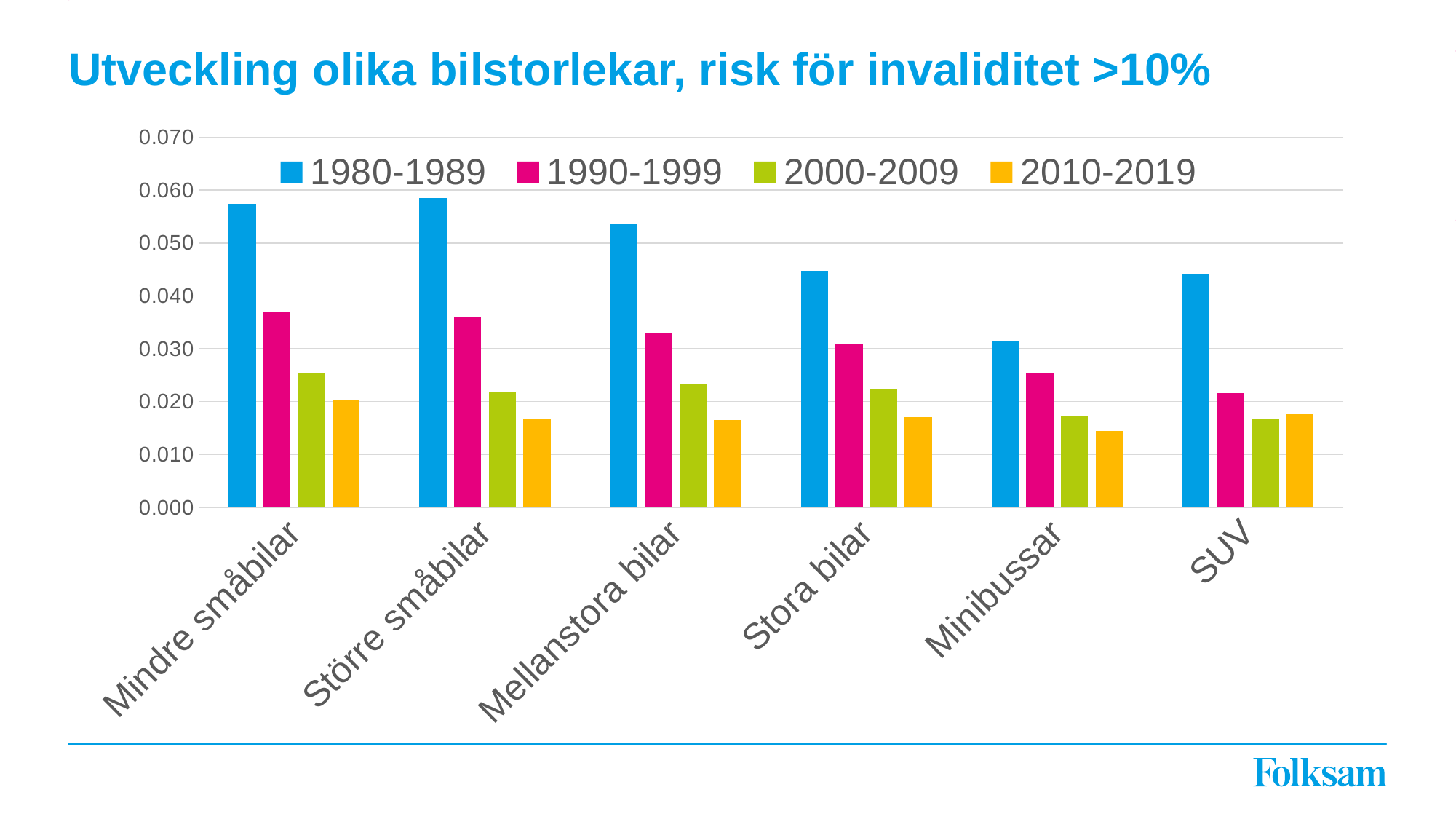
What kind of chart is shown on the slide? Bar chart How many vehicle categories are shown on the x axis? 6 Is the 1980-1989 value for Mindre småbilar greater or less than 0.050? greater Is the 1980-1989 value for Minibussar greater or less than 0.040? less What is the title of the chart? Utveckling olika bilstorlekar, risk för invaliditet >10% Which is larger for the 1980-1989 series: Stora bilar or Minibussar? Stora bilar How many series does the legend list? 4 Which vehicle category has the lowest value for the 2010-2019 series? Minibussar Which vehicle category has the lowest value for the 1980-1989 series? Minibussar Which vehicle category has the lowest value for the 1990-1999 series? SUV For Mindre småbilar, do the values rise or fall from 1980-1989 to 2010-2019? fall Is the 1990-1999 value for SUV greater or less than 0.030? less